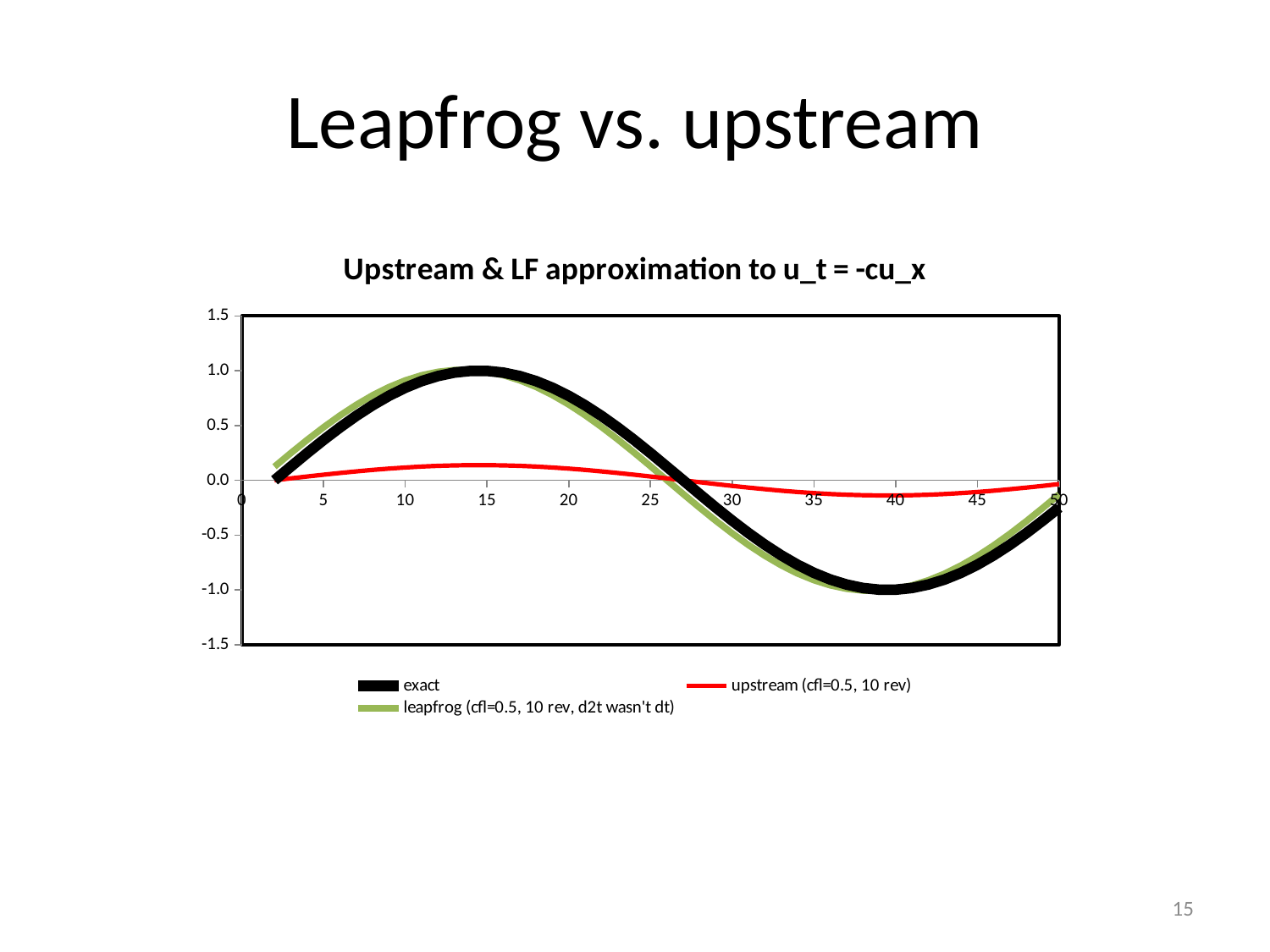
Does the exact series rise or fall between x = 15 and x = 40? fall How many series does the legend list? 3 At x = 40, which series has the larger value: exact or upstream? upstream Which series is drawn in red? upstream (cfl=0.5, 10 rev) Is the value of the upstream series at x = 40 greater or less than -0.5? greater At x = 15, which series has the larger value: exact or upstream? exact What is the title of the chart? Upstream & LF approximation to u_t = -cu_x Is the value of the exact series at x = 40 greater or less than -0.5? less What kind of chart is shown on the slide? line chart Is the value of the exact series at x = 15 greater or less than 0.5? greater Does the exact series rise or fall between x = 0 and x = 15? rise